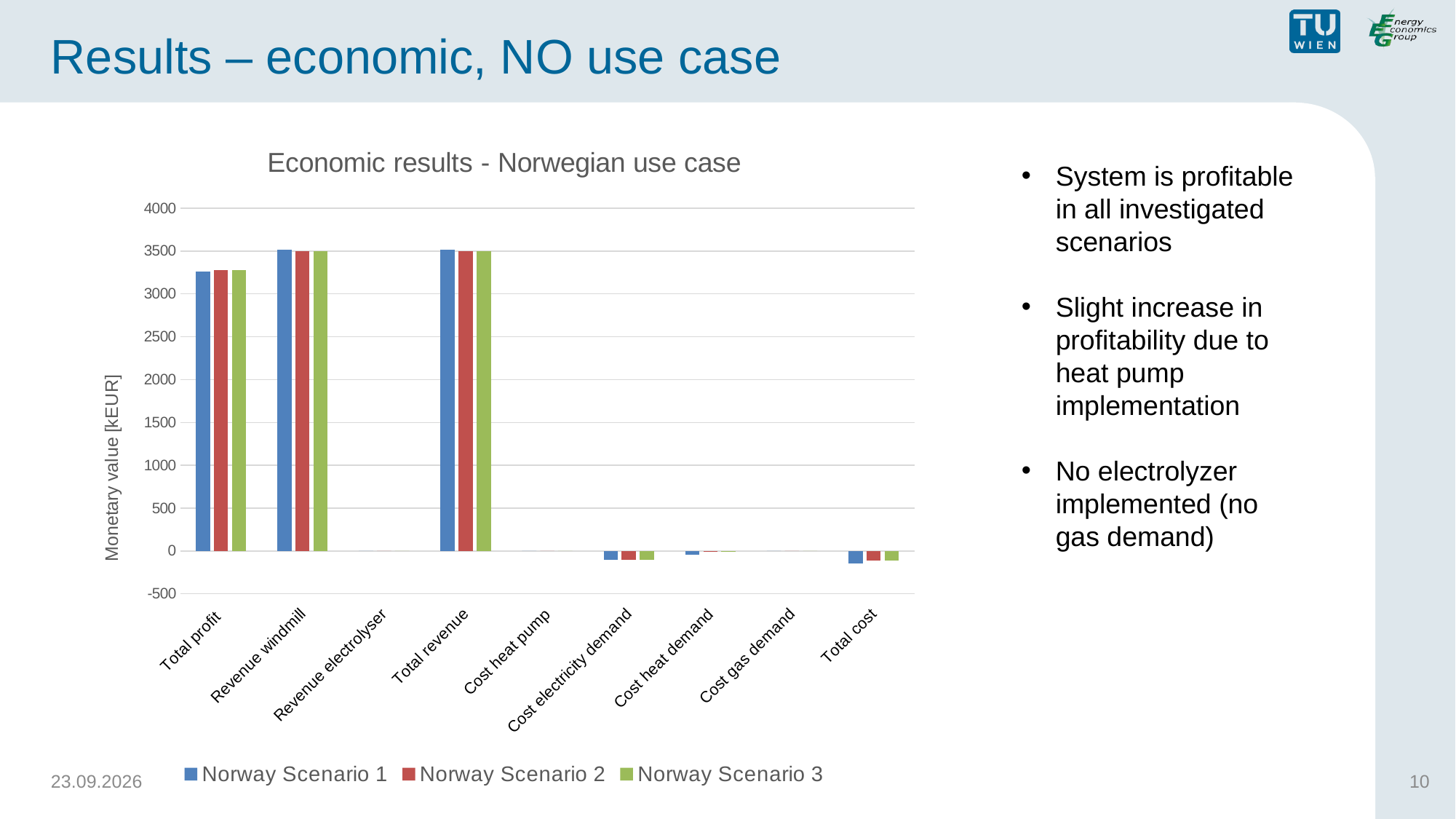
What is the label of the vertical axis of the chart? Monetary value [kEUR] What kind of chart is shown on the slide? bar chart Is the value for Total cost in Norway Scenario 2 greater or less than 0? less For Norway Scenario 1, which is larger: Total profit or Revenue windmill? Revenue windmill How many series does the chart's legend list? 3 Is the value for Total revenue in Norway Scenario 3 greater or less than 3000? greater Is the value for Revenue windmill in Norway Scenario 2 greater or less than 3000? greater What is the title of the chart? Economic results - Norwegian use case Which category has the lowest value for Norway Scenario 1? Total cost How many categories are shown on the x axis of the chart? 9